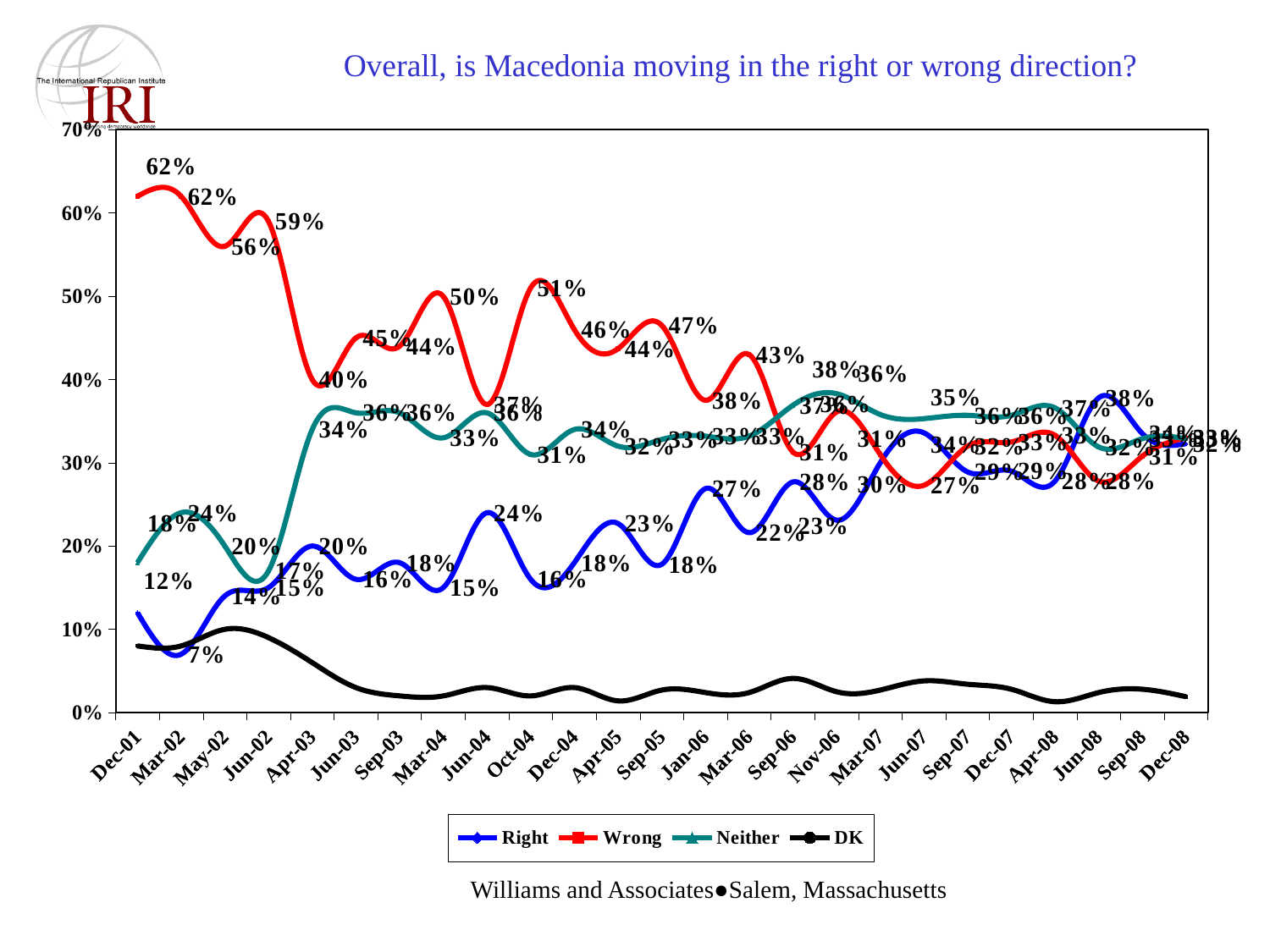
At which date was the Right series at its lowest? Mar-02 Does the Wrong series generally rise or fall from Dec-01 to Dec-08? Fall How many series does the legend list? 4 What was the value for Neither in Dec-01? 18% What was the value for Wrong in Dec-01? 62% What was the value for Right in Mar-02? 7% In Dec-01, which was larger, Right or Wrong? Wrong Is the value for DK in Dec-08 greater or less than 10%? less What type of chart is shown on the slide? Line chart What is the difference between Wrong and Right in Dec-01? 50 percentage points How many survey dates are shown along the x axis? 25 What was the value for Wrong in Oct-04? 51%